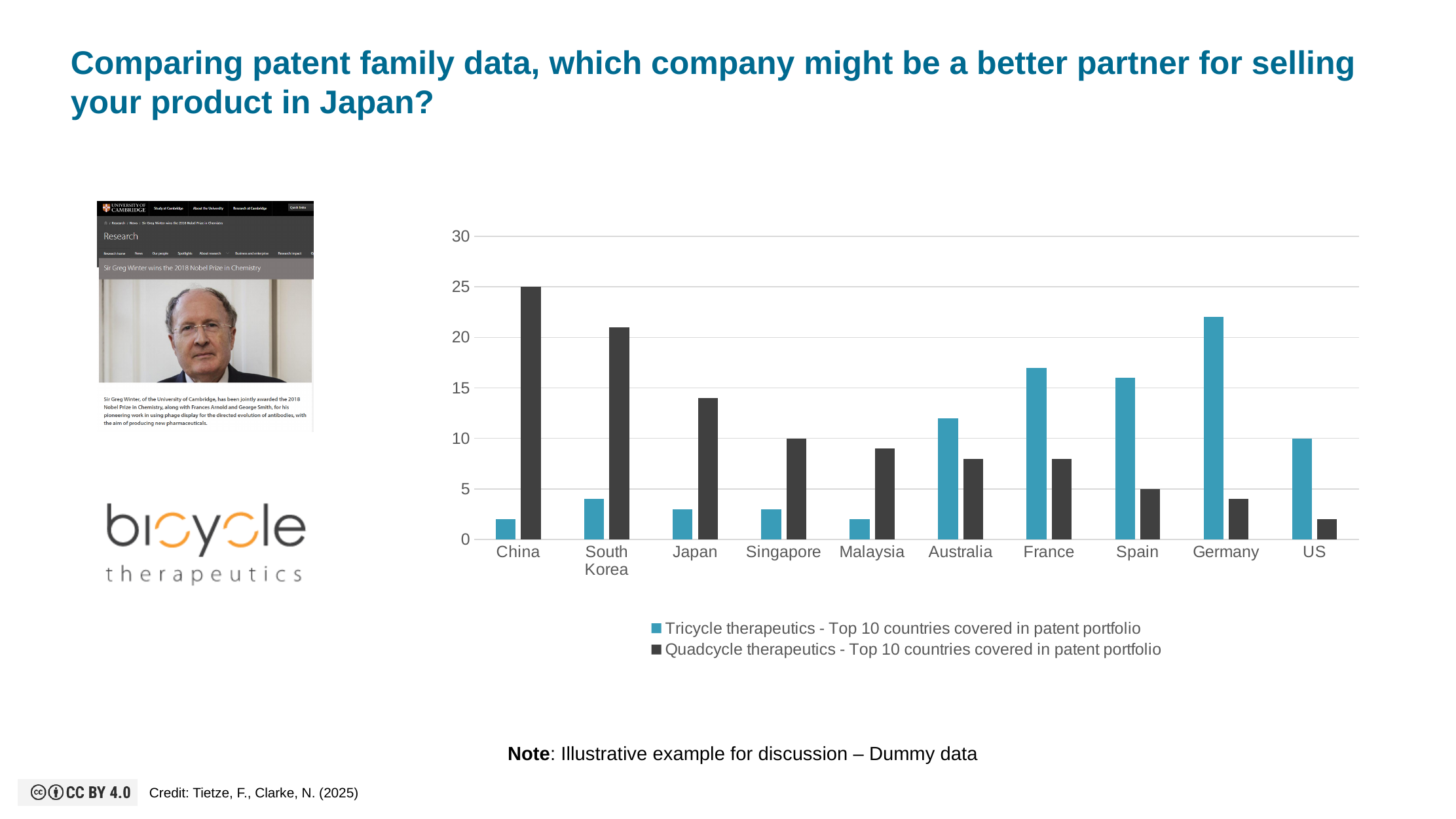
Which country has the lowest value in the Quadcycle therapeutics series? US What is the value for China in the Quadcycle therapeutics series? 25 What is the value for Spain in the Quadcycle therapeutics series? 5 Which country has the highest value in the Tricycle therapeutics series? Germany For Japan, which series has the larger value, Tricycle therapeutics or Quadcycle therapeutics? Quadcycle therapeutics What is the value for Singapore in the Quadcycle therapeutics series? 10 What is the value for US in the Tricycle therapeutics series? 10 How many series does the chart's legend list? 2 What kind of chart is shown on the slide? bar chart How many countries are shown on the x axis of the chart? 10 Is the value for Germany in the Tricycle therapeutics series greater or less than 20? greater Which country has the highest value in the Quadcycle therapeutics series? China